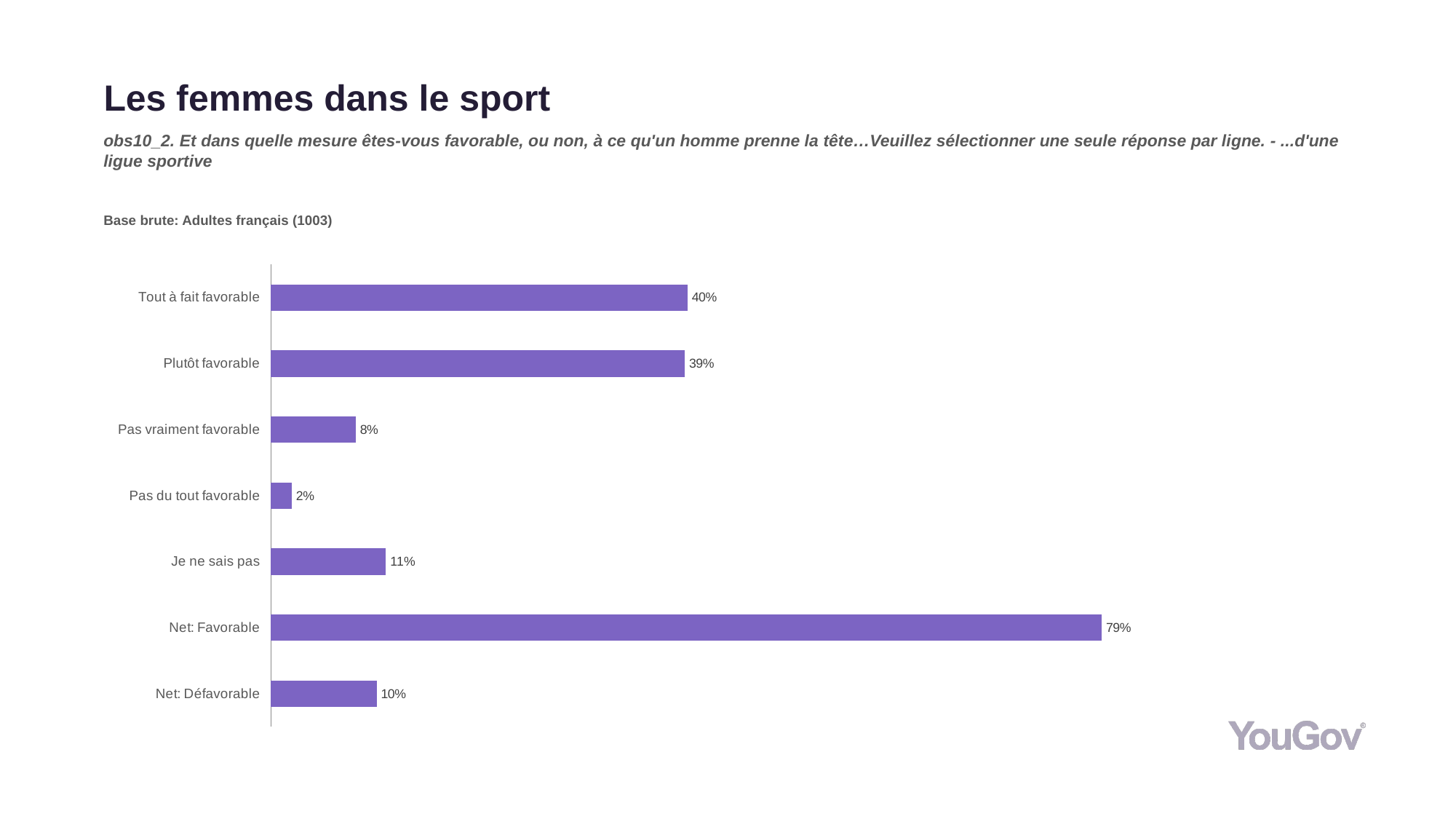
How many categories are shown in the chart? 7 What is the value for "Plutôt favorable"? 39% Which category has the lowest value? Pas du tout favorable What is the difference between "Net: Favorable" and "Net: Défavorable"? 69 percentage points What is the value for "Pas vraiment favorable"? 8% Which is larger, "Je ne sais pas" or "Pas vraiment favorable"? Je ne sais pas What is the value for "Je ne sais pas"? 11% What is the value for "Tout à fait favorable"? 40% What kind of chart is shown on the slide? Bar chart What is the value for "Net: Défavorable"? 10% Which category has the highest value? Net: Favorable What is the difference between "Tout à fait favorable" and "Plutôt favorable"? 1 percentage point